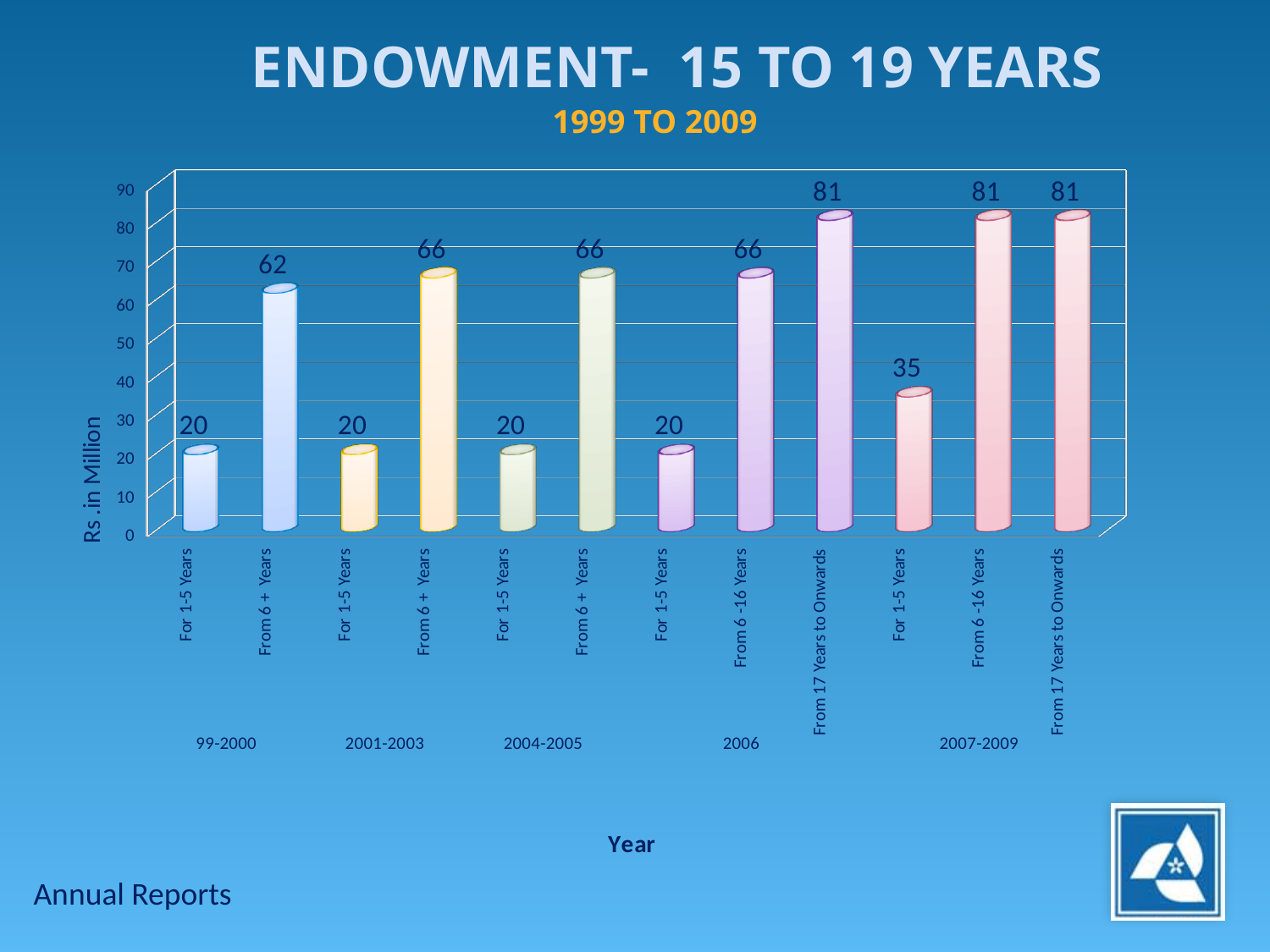
What is the label of the vertical axis? Rs .in Million What is the value for 'From 6 -16 Years' in 2006? 66 What type of chart is shown on the slide? Bar chart What is the title of the chart? ENDOWMENT- 15 TO 19 YEARS Which is larger: 'For 1-5 Years' in 2007-2009 or 'For 1-5 Years' in 2006? For 1-5 Years in 2007-2009 What is the value for 'From 17 Years to Onwards' in 2006? 81 What is the lowest value shown in the chart? 20 What is the value for 'For 1-5 Years' in 2007-2009? 35 How many bars are plotted in the chart? 12 What is the difference between 'From 6 + Years' in 2001-2003 and 'For 1-5 Years' in 2001-2003? 46 What is the highest value shown in the chart? 81 What is the value for 'From 6 + Years' in 99-2000? 62